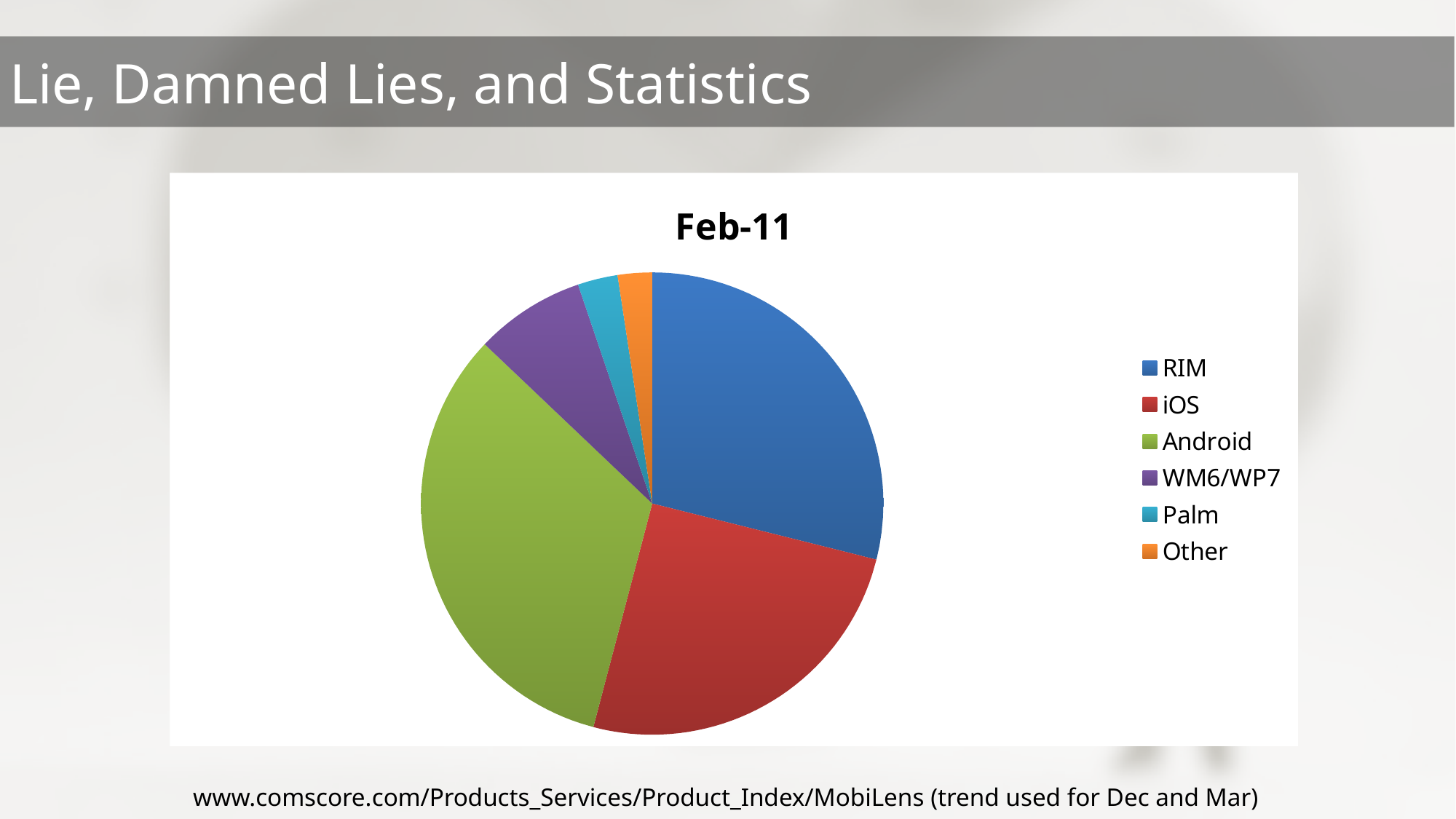
How many categories does the legend of the pie chart list? 6 Which slice is larger, RIM or iOS? RIM How many slices does the pie chart have? 6 Which colour represents Android in the pie chart? green Which category has the largest slice of the pie chart? Android What is the title of the chart? Feb-11 Which slice is larger, Android or RIM? Android Which slice is larger, iOS or WM6/WP7? iOS What kind of chart is shown on the slide? pie chart Which category is listed first in the legend? RIM